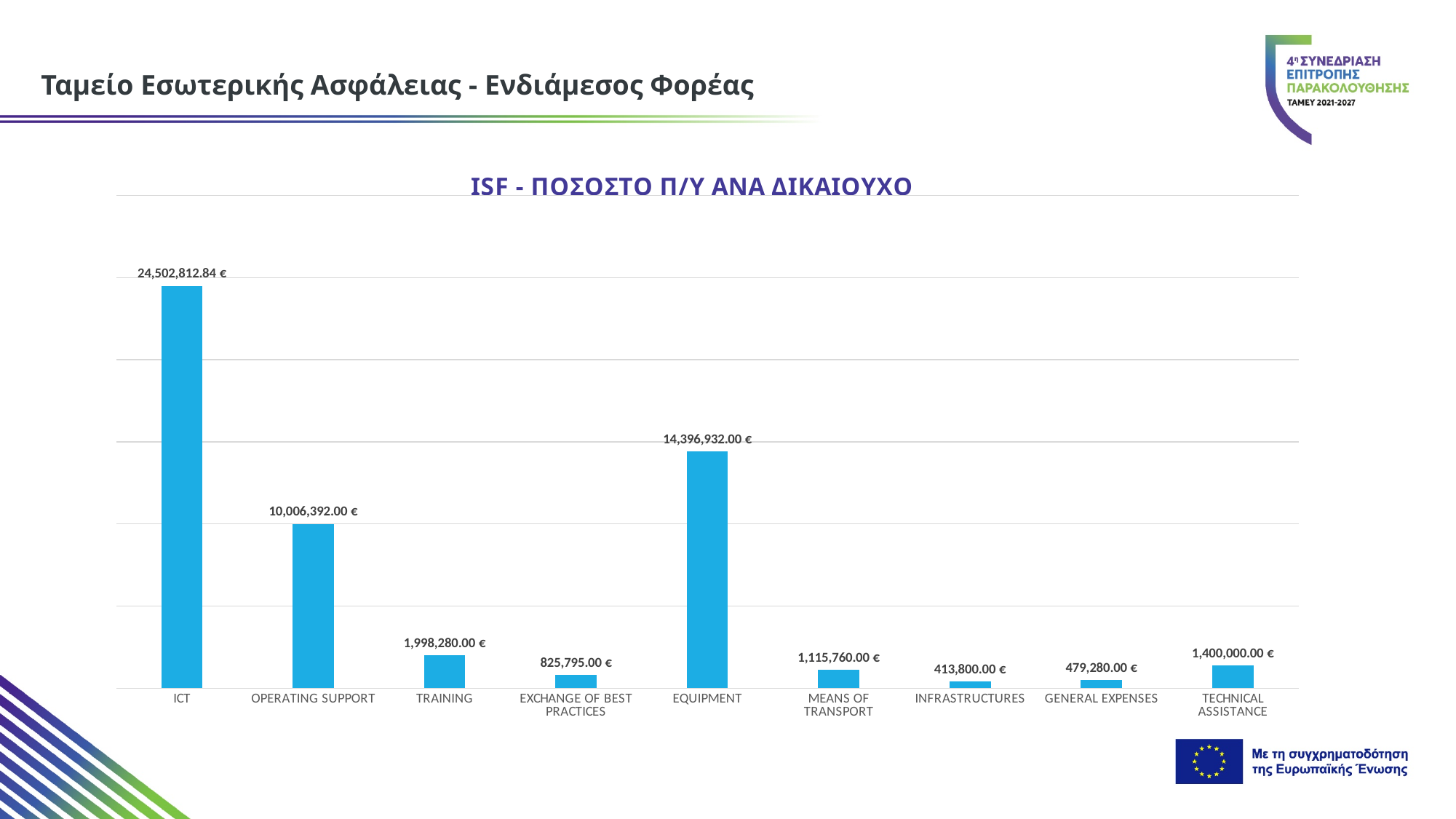
What is the difference between the values for ICT and EQUIPMENT? 10,105,880.84 € What is the value for ICT? 24,502,812.84 € How many categories are shown on the x axis? 9 What kind of chart is shown on the slide? Bar chart Which category has the highest value? ICT Which category has the lowest value? INFRASTRUCTURES What is the difference between the values for OPERATING SUPPORT and TRAINING? 8,008,112.00 € Which is larger, the value for TECHNICAL ASSISTANCE or the value for MEANS OF TRANSPORT? TECHNICAL ASSISTANCE What is the value for EQUIPMENT? 14,396,932.00 € What is the title of the chart? ISF - ΠΟΣΟΣΤΟ Π/Υ ΑΝΑ ΔΙΚΑΙΟΥΧΟ What is the value for MEANS OF TRANSPORT? 1,115,760.00 € What is the value for EXCHANGE OF BEST PRACTICES? 825,795.00 €